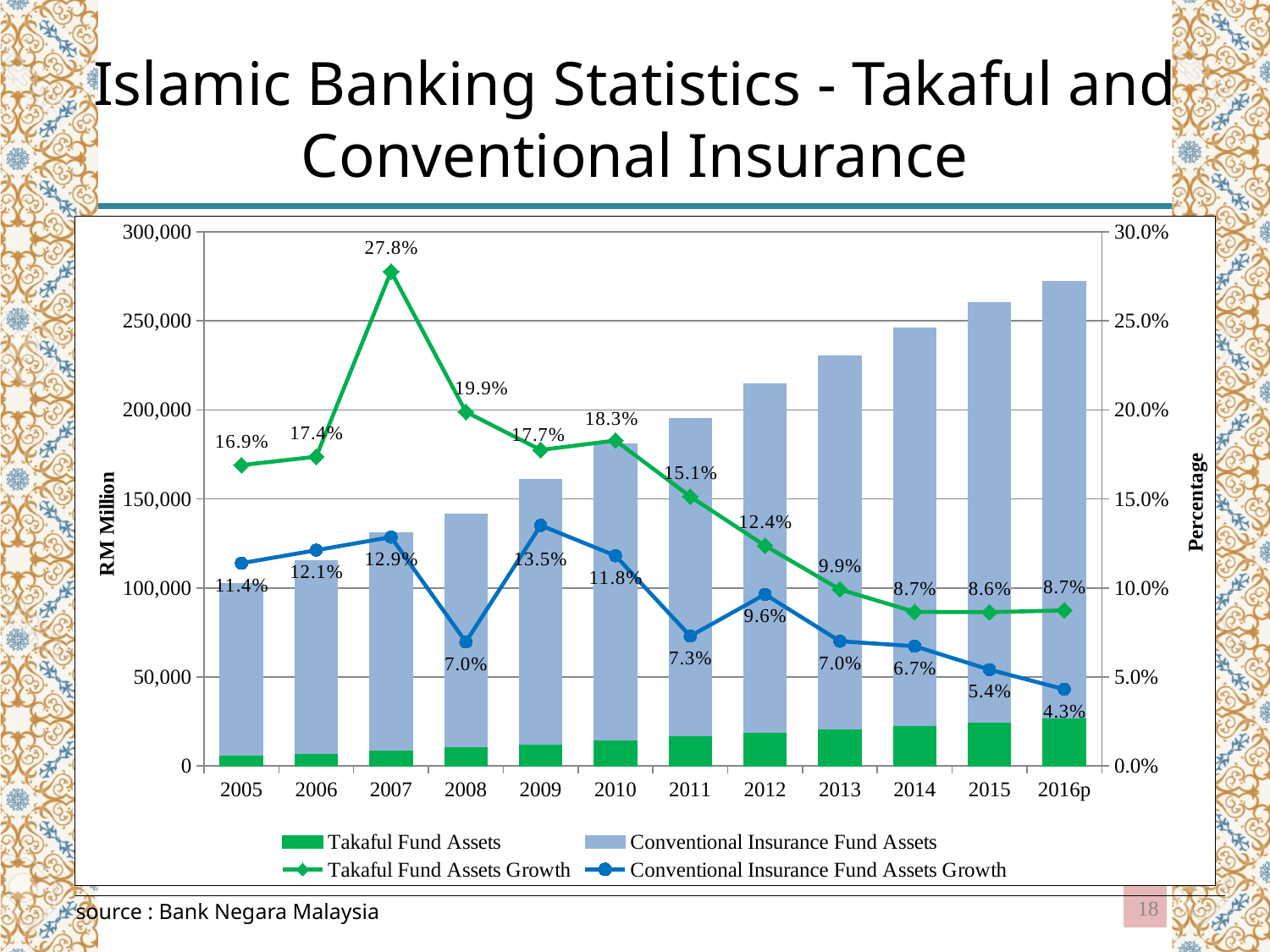
What is the Conventional Insurance Fund Assets Growth value for 2016p? 4.3% What is the title of the right-hand vertical axis? Percentage How many series does the legend list? 4 In which year is Takaful Fund Assets Growth highest? 2007 In which year is Conventional Insurance Fund Assets Growth lowest? 2016p Is the total fund assets bar for 2016p greater or less than 250,000? greater In 2009, which is higher: Takaful Fund Assets Growth or Conventional Insurance Fund Assets Growth? Takaful Fund Assets Growth What is the Takaful Fund Assets Growth value for 2007? 27.8% What is the difference between Takaful Fund Assets Growth and Conventional Insurance Fund Assets Growth in 2007? 14.9 percentage points How many years are shown on the x axis? 12 What kind of chart is shown on the slide? Combination stacked bar and line chart Does Takaful Fund Assets Growth rise or fall from 2010 to 2015? Fall